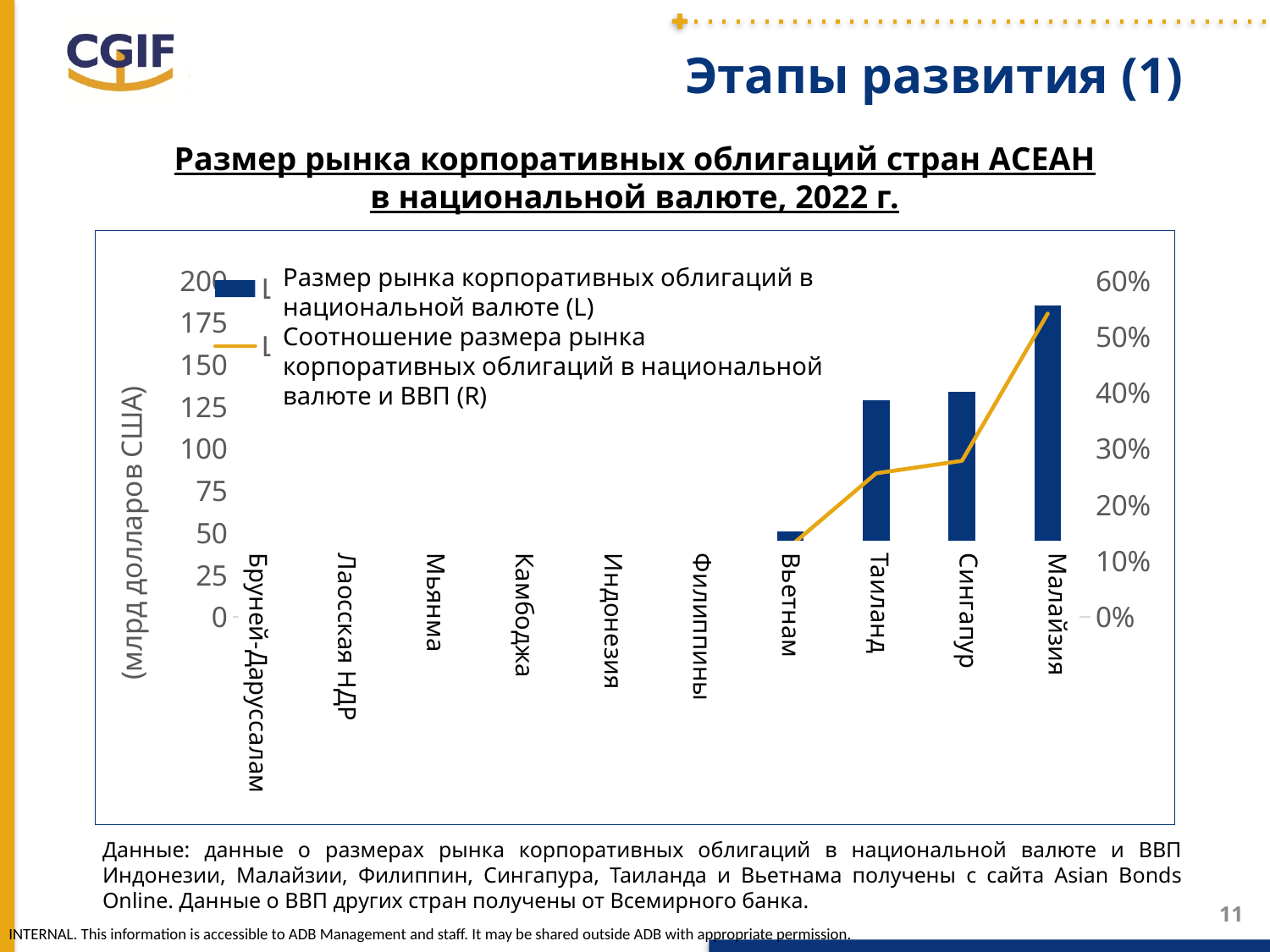
Is the ratio to GDP for Вьетнам greater or less than 20%? less What kind of chart is shown on the slide? Bar chart combined with a line Which bar is larger, Вьетнам or Таиланд? Таиланд How many series does the chart legend list? 2 What is the unit shown on the left vertical axis of the chart? млрд долларов США Which country has the tallest bar for the size of the local currency corporate bond market? Малайзия Is the bar value for Малайзия greater or less than 150 billion US dollars? greater How many countries are listed along the x axis of the chart? 10 Is the bar value for Таиланд greater or less than 100 billion US dollars? greater Does the line for the ratio to GDP rise or fall from Вьетнам to Малайзия? rise Which country has the highest ratio of corporate bond market size to GDP on the line series? Малайзия